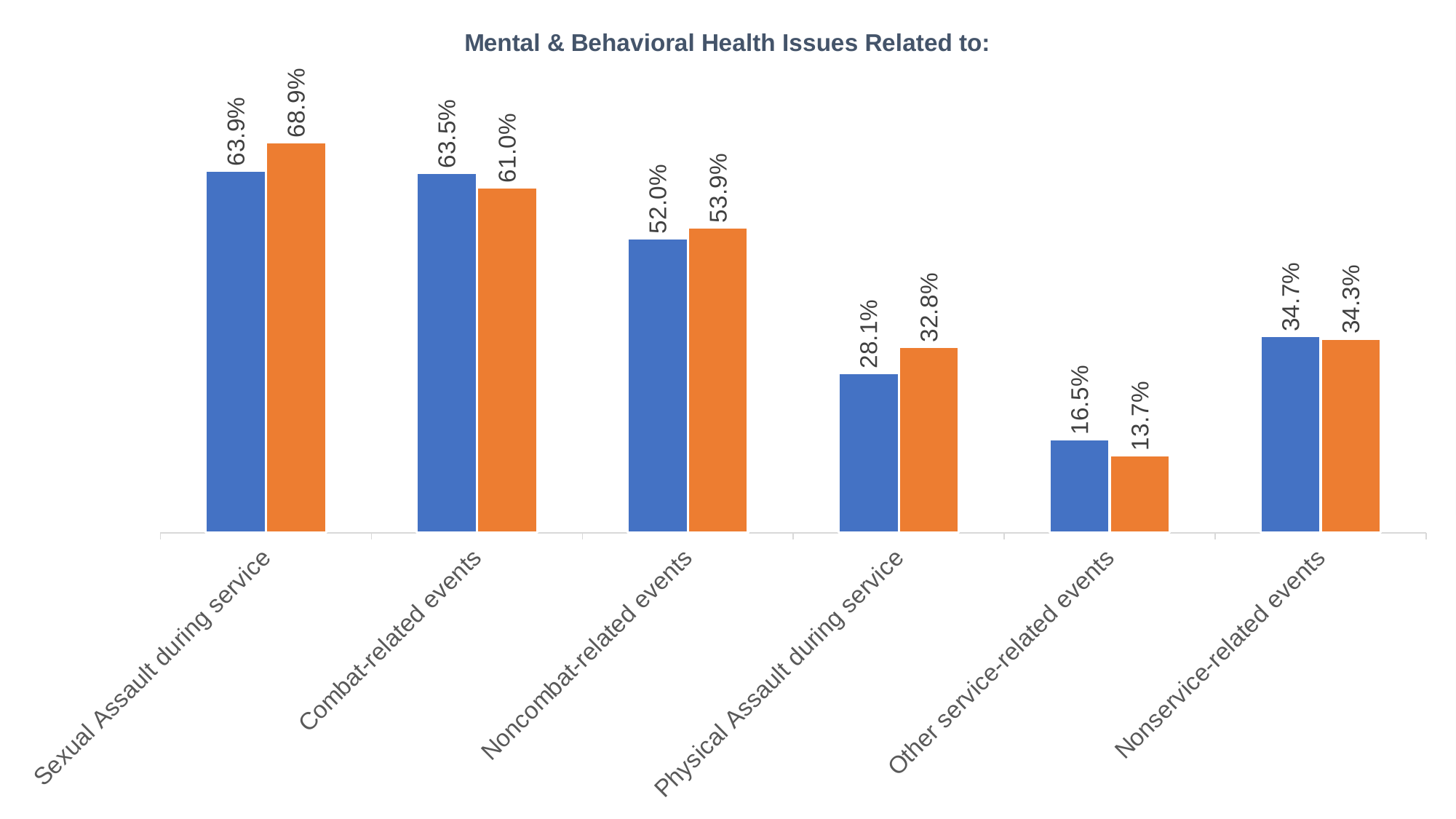
What is the value of the blue bar for Combat-related events? 63.5% Which category has the highest orange bar? Sexual Assault during service What is the value of the blue bar for Nonservice-related events? 34.7% What is the value of the orange bar for Other service-related events? 13.7% What is the difference between the orange and blue bars for Sexual Assault during service? 5.0 percentage points What is the value of the orange bar for Physical Assault during service? 32.8% What kind of chart is shown on the slide? bar chart What is the title of the chart? Mental & Behavioral Health Issues Related to: Which category has the lowest blue bar? Other service-related events How many categories are shown on the x axis? 6 For Physical Assault during service, which bar is larger, blue or orange? orange What is the difference between the blue and orange bars for Combat-related events? 2.5 percentage points